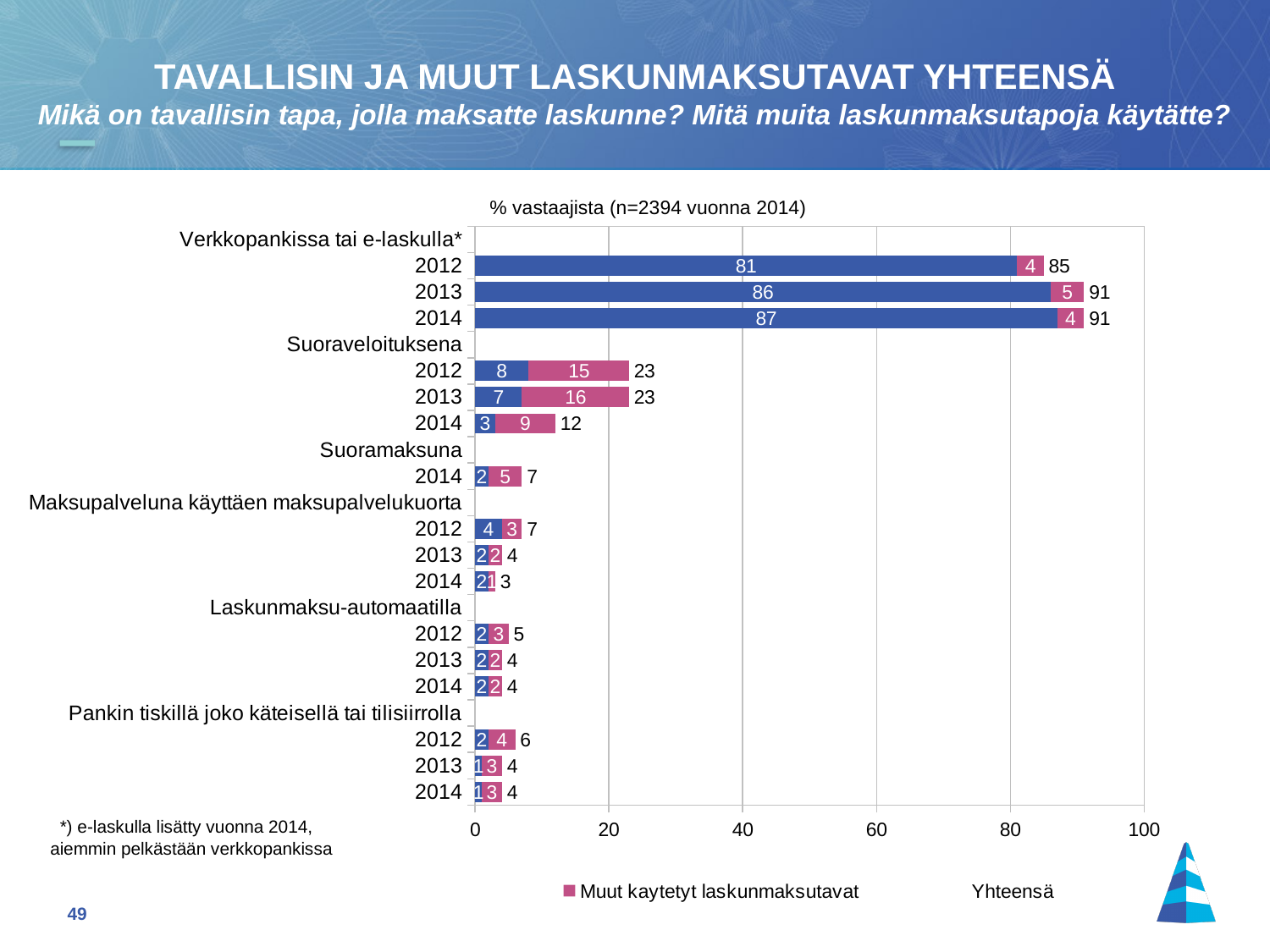
What type of chart is shown on the slide? Stacked horizontal bar chart What is the difference between the total for Verkkopankissa tai e-laskulla in 2012 and in 2013? 6 What is the total value for Suoramaksuna in 2014? 7 What is the total value for Suoraveloituksena in 2014? 12 Which payment method has the highest total value in 2014? Verkkopankissa tai e-laskulla* What is the difference between the total for Suoraveloituksena in 2013 and in 2014? 11 Is the total value for Verkkopankissa tai e-laskulla in 2012 greater or less than 80? greater What is the 'Muut käytetyt laskunmaksutavat' value for Suoraveloituksena in 2013? 16 What is the total (Yhteensä) value for Verkkopankissa tai e-laskulla in 2014? 91 Which is larger: the total for Pankin tiskillä joko käteisellä tai tilisiirrolla in 2012 or the total for Laskunmaksu-automaatilla in 2012? Pankin tiskillä joko käteisellä tai tilisiirrolla in 2012 How does the total for Suoraveloituksena change from 2012 to 2014? It falls (23 to 12) What is the subtitle above the chart describing the unit of the values? % vastaajista (n=2394 vuonna 2014)